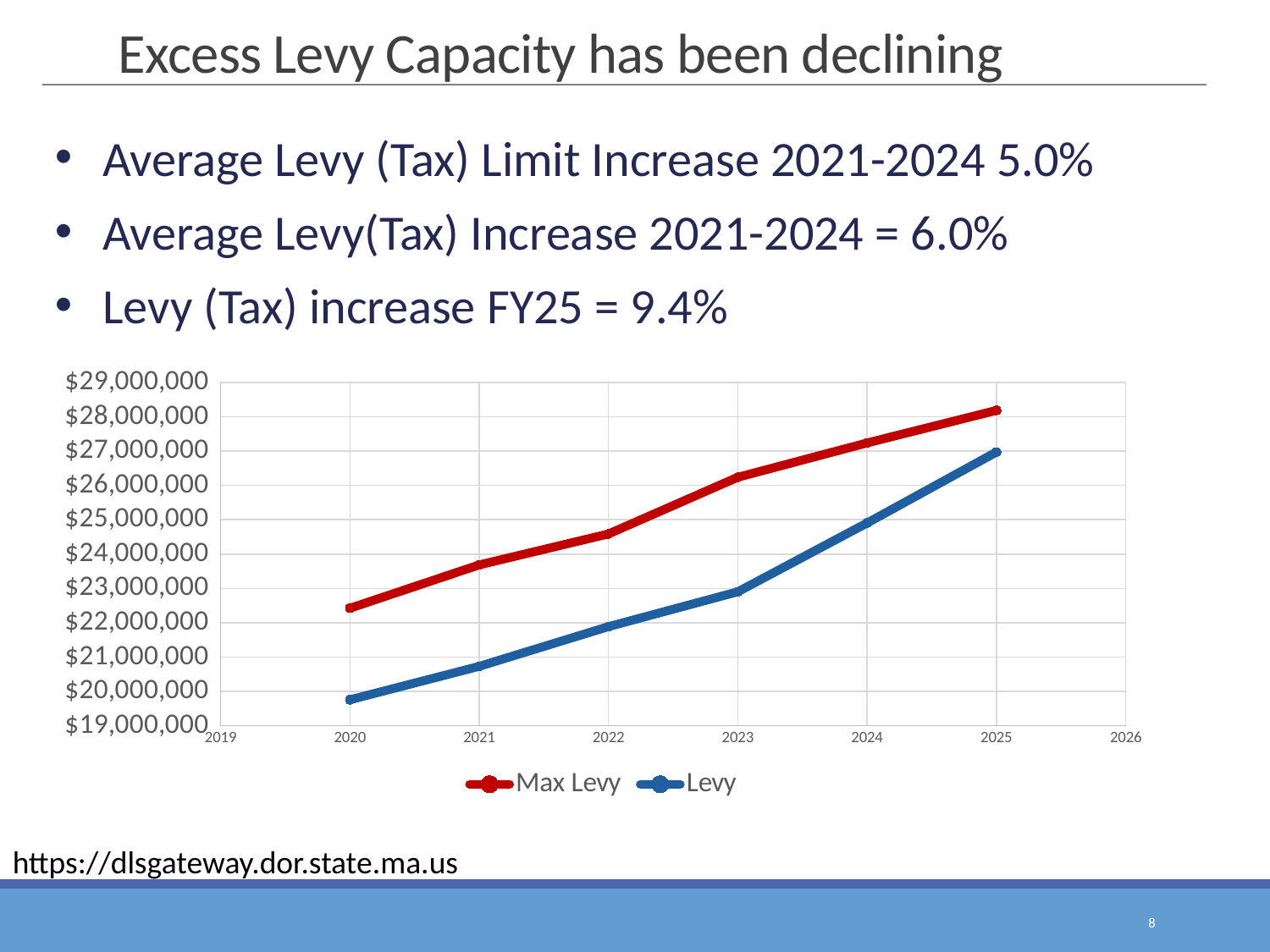
In 2022, which is larger, Max Levy or Levy? Max Levy In which year is the Max Levy series at its highest? 2025 In which year is the Levy series at its lowest? 2020 How many series does the chart legend list? 2 What colour is the Max Levy line in the chart? red What kind of chart is shown on the slide? line chart Is the Levy value for 2023 greater or less than $24,000,000? less How many years have data points plotted for the Levy series? 6 Is the Levy value for 2025 greater or less than $26,000,000? greater Is the Max Levy value for 2020 greater or less than $22,000,000? greater Do the Levy values rise or fall from 2020 to 2025? rise